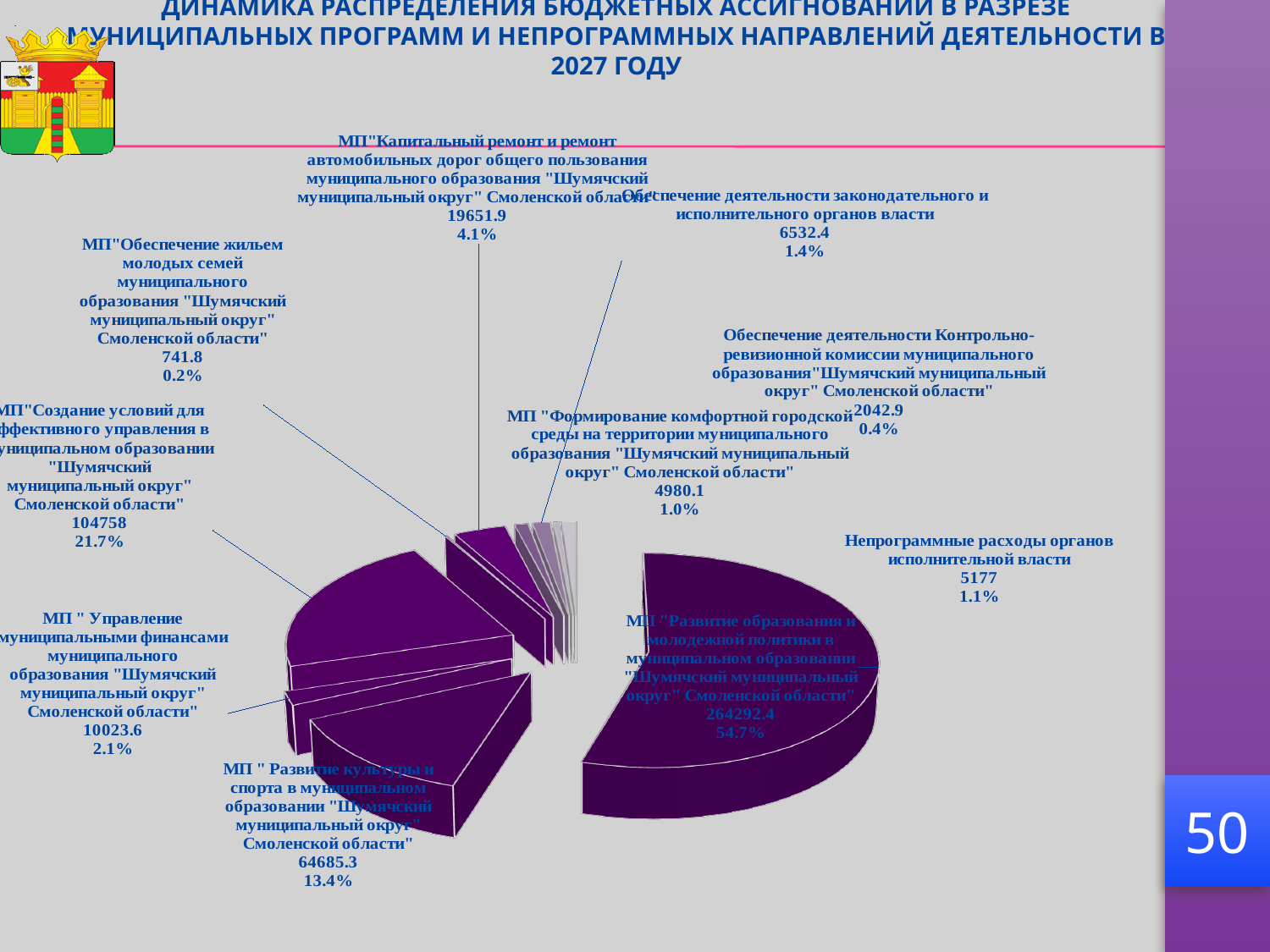
What is the value for МП "Формирование комфортной городской среды"? 4980.1 What share of the pie does МП "Создание условий для эффективного управления" represent? 21.7% What is the value for МП "Развитие образования и молодежной политики"? 264292.4 What kind of chart is shown on the slide? pie chart What is the difference between the value for Обеспечение деятельности законодательного и исполнительного органов власти and the value for Обеспечение деятельности Контрольно-ревизионной комиссии? 4489.5 Which category has the smallest slice of the pie? МП "Обеспечение жильем молодых семей" Which category has the largest slice of the pie? МП "Развитие образования и молодежной политики" How many slices (categories) does the pie chart have? 10 Which is larger: the value for МП "Капитальный ремонт и ремонт автомобильных дорог" or the value for МП "Управление муниципальными финансами"? МП "Капитальный ремонт и ремонт автомобильных дорог" Which year does the chart title refer to? 2027 What share of the pie does МП "Развитие культуры и спорта" represent? 13.4% What is the value for Непрограммные расходы органов исполнительной власти? 5177